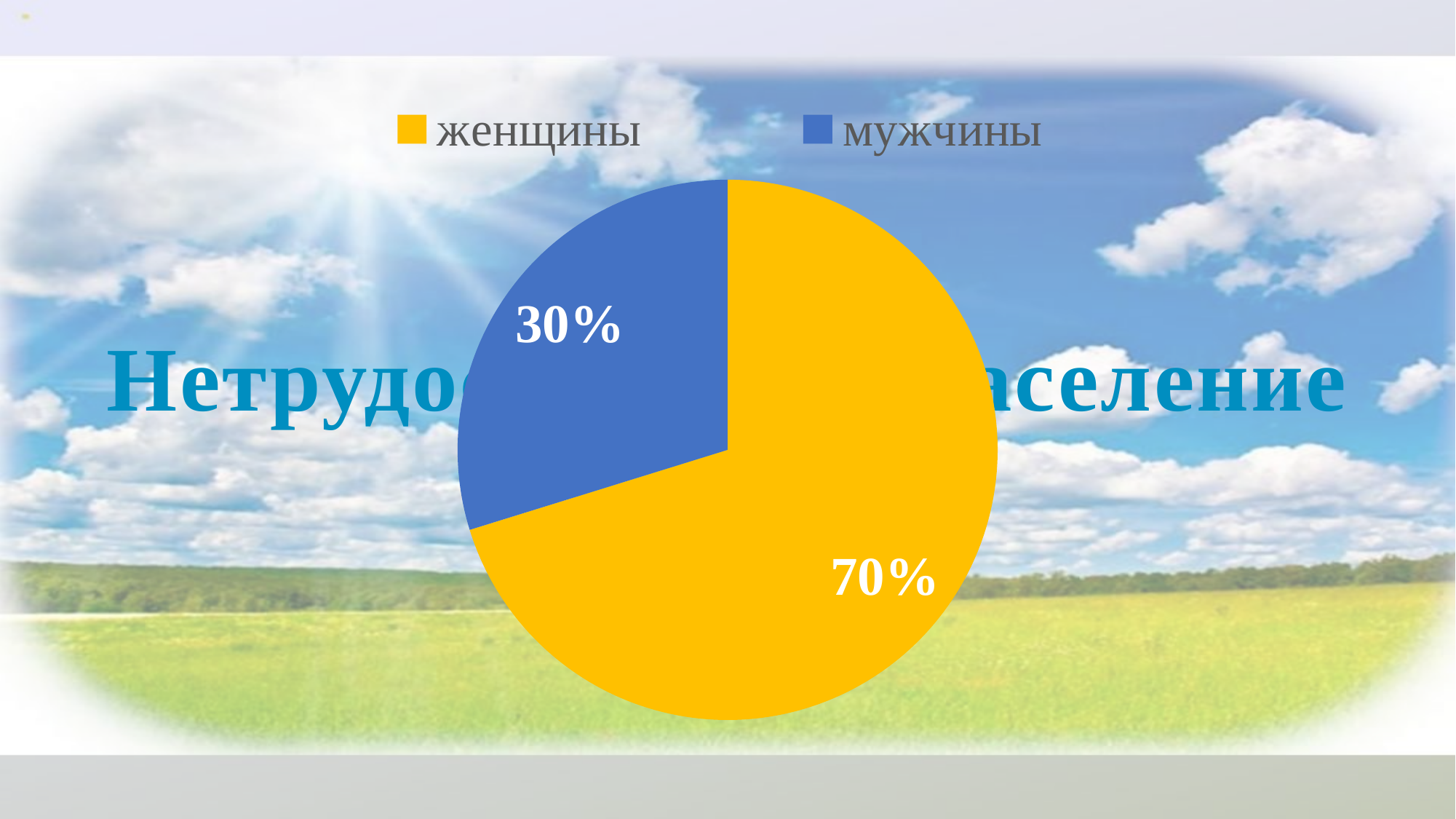
What is the difference between the shares for женщины and мужчины? 40% Which is larger, the slice for женщины or the slice for мужчины? женщины Which category has the smallest slice of the pie? мужчины What share of the pie does женщины have? 70% What colour is the slice for мужчины? blue How many entries does the legend list? 2 What share of the pie does мужчины have? 30% What colour is the slice for женщины? yellow How many slices does the pie chart have? 2 What kind of chart is shown on the slide? pie chart Which category has the largest slice of the pie? женщины